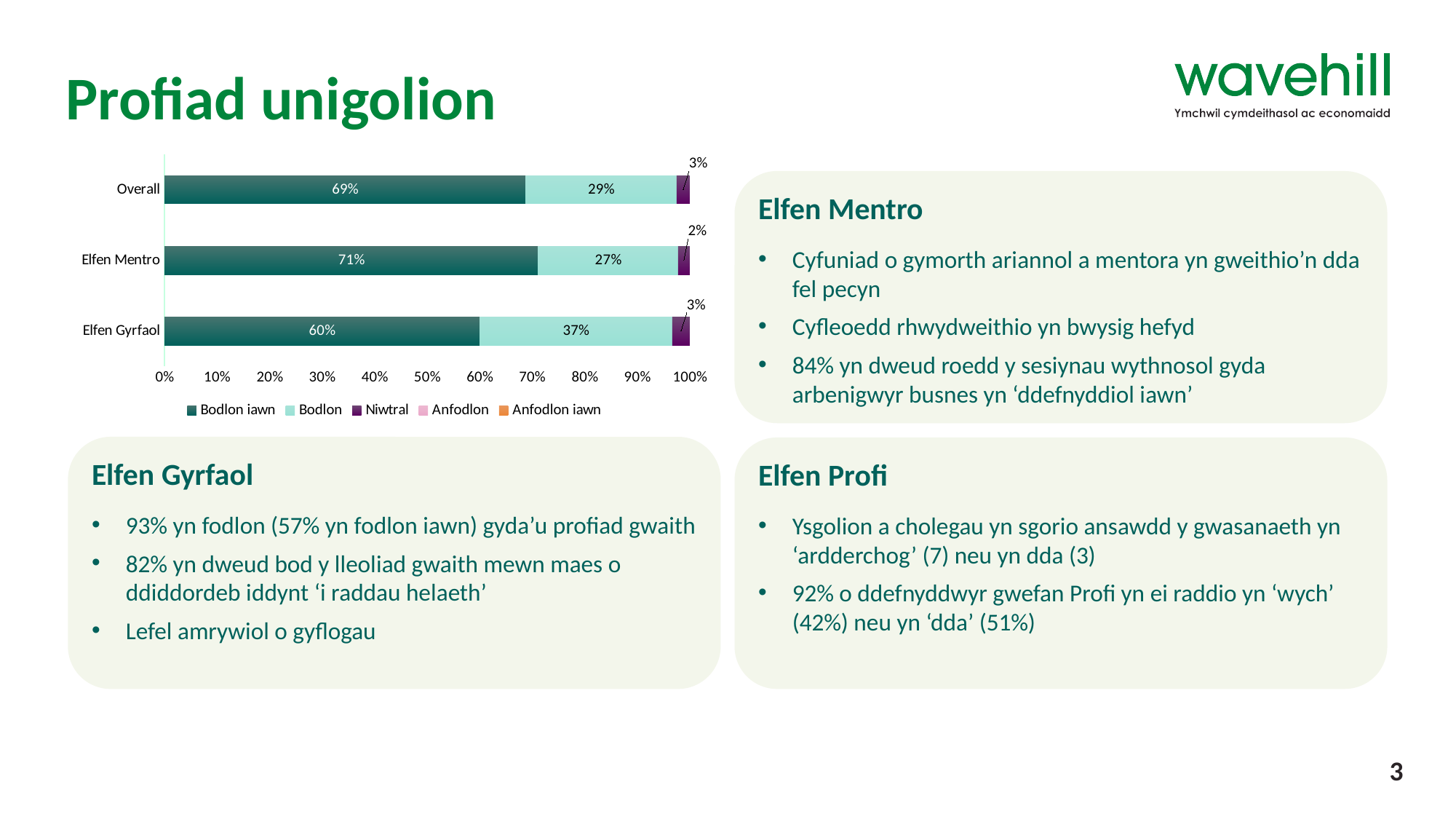
How many series does the chart legend list? 5 Which category has the highest 'Bodlon iawn' value? Elfen Mentro What is the 'Bodlon iawn' value for Elfen Mentro? 71% What is the 'Niwtral' value for Overall? 3% What is the 'Bodlon' value for Elfen Gyrfaol? 37% Which category has the lowest 'Bodlon iawn' value? Elfen Gyrfaol Which is larger: the 'Bodlon' value for Elfen Gyrfaol or for Elfen Mentro? Elfen Gyrfaol What is the difference between the 'Bodlon iawn' values for Elfen Mentro and Elfen Gyrfaol? 11 percentage points How many categories are plotted on the chart? 3 What kind of chart is shown on the slide? Stacked bar chart Which series in the legend is shown in orange? Anfodlon iawn What is the 'Bodlon iawn' value for Overall? 69%